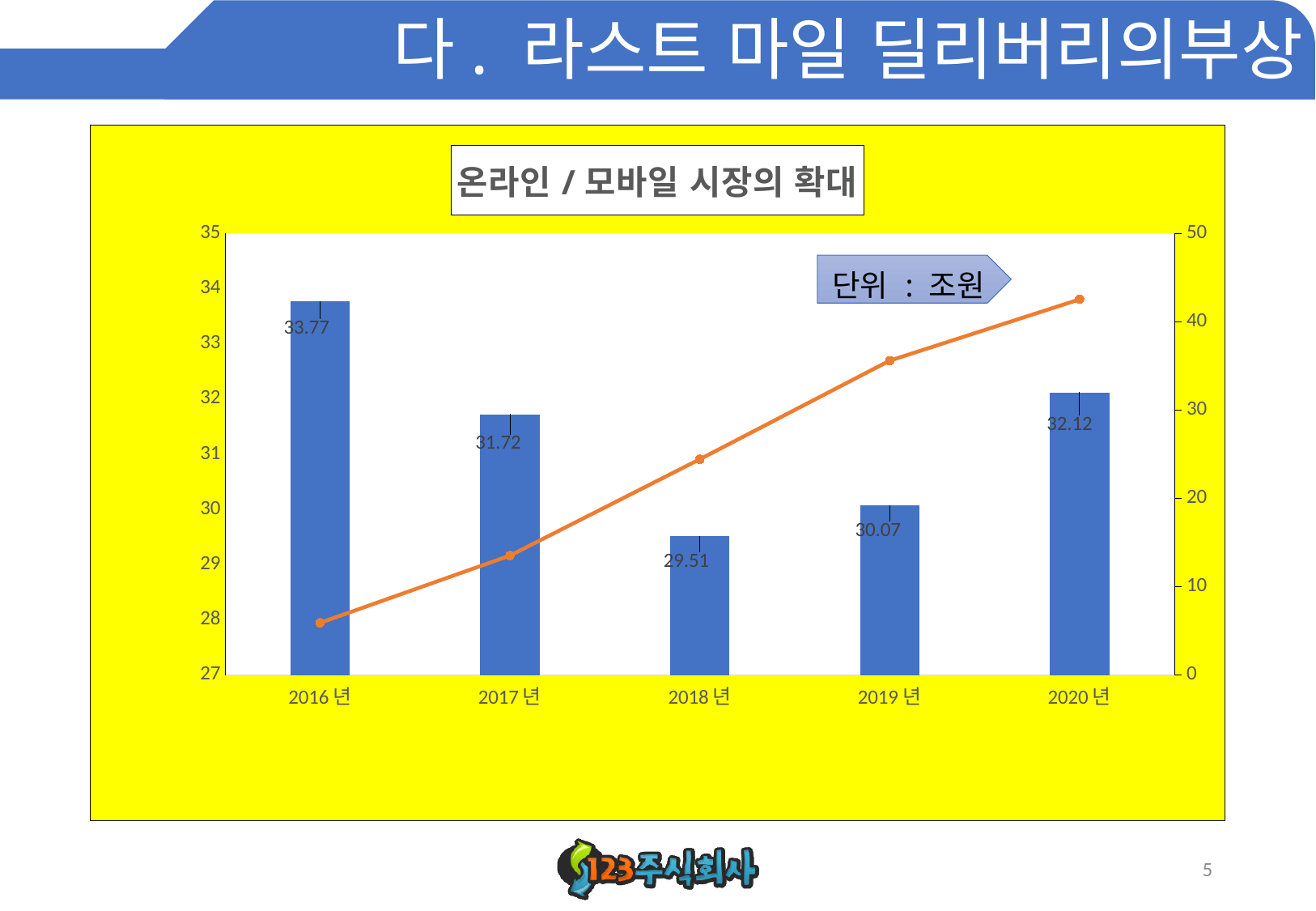
What is the difference between the bar values for 2016 년 and 2018 년? 4.26 How many years are shown on the x axis? 5 What is the title of the chart? 온라인 / 모바일 시장의 확대 On the right-hand axis, is the line value for 2020 년 greater or less than 40? greater Which is larger, the bar value for 2017 년 or for 2020 년? 2020 년 What is the bar value for 2016 년? 33.77 On the right-hand axis, is the line value for 2016 년 greater or less than 10? less Does the orange line rise or fall from 2016 년 to 2020 년? rise Which year has the highest bar value? 2016 년 What is the bar value for 2020 년? 32.12 Which year has the lowest bar value? 2018 년 What is the bar value for 2018 년? 29.51